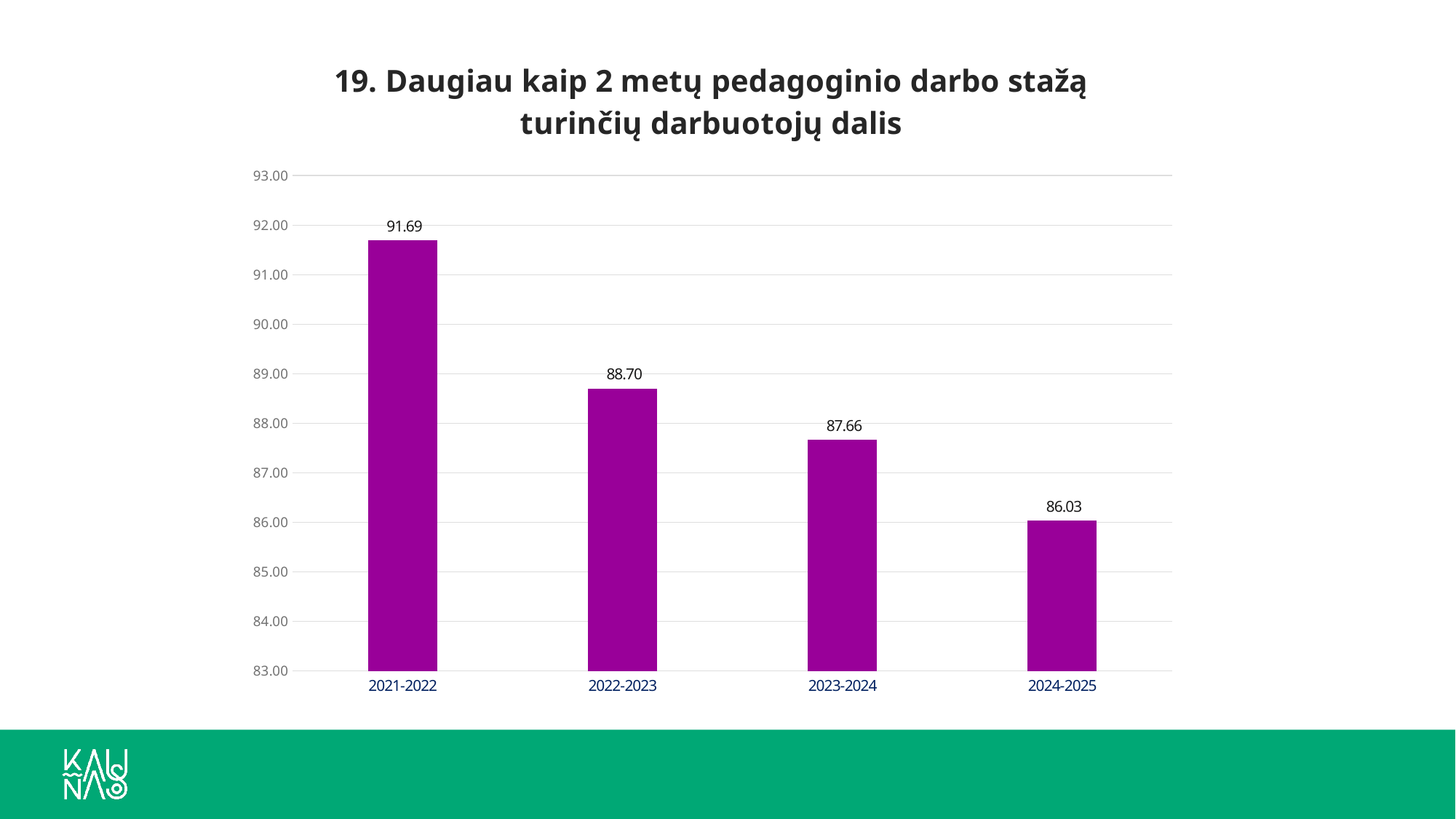
What is the difference between the values for 2021-2022 and 2024-2025? 5.66 Which period has the lowest value? 2024-2025 Do the values rise or fall from 2021-2022 to 2024-2025? Fall Which period has the highest value? 2021-2022 What is the value for 2022-2023? 88.70 Which is larger, the value for 2022-2023 or the value for 2024-2025? 2022-2023 What is the difference between the values for 2022-2023 and 2023-2024? 1.04 How many periods are shown on the x axis? 4 What is the value for 2023-2024? 87.66 What is the value for 2021-2022? 91.69 What is the value for 2024-2025? 86.03 What kind of chart is shown on the slide? Bar chart